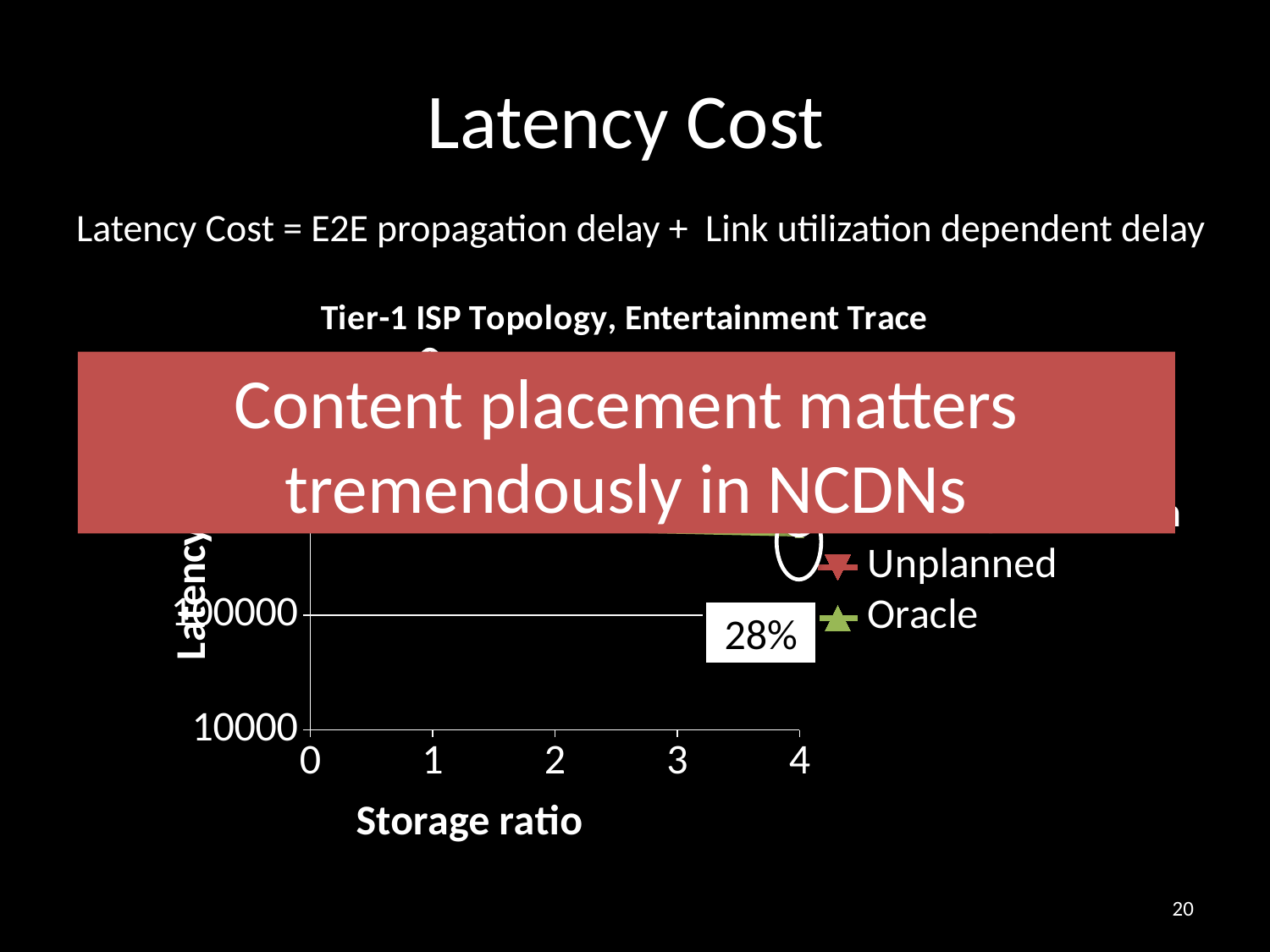
What is the title of the chart? Tier-1 ISP Topology, Entertainment Trace What is the lowest tick value shown on the chart's y axis? 10000 What is the label of the chart's x axis? Storage ratio What kind of chart is shown on the slide? line chart How many tick marks are labelled on the chart's x axis? 5 What is the highest tick value shown on the chart's x axis? 4